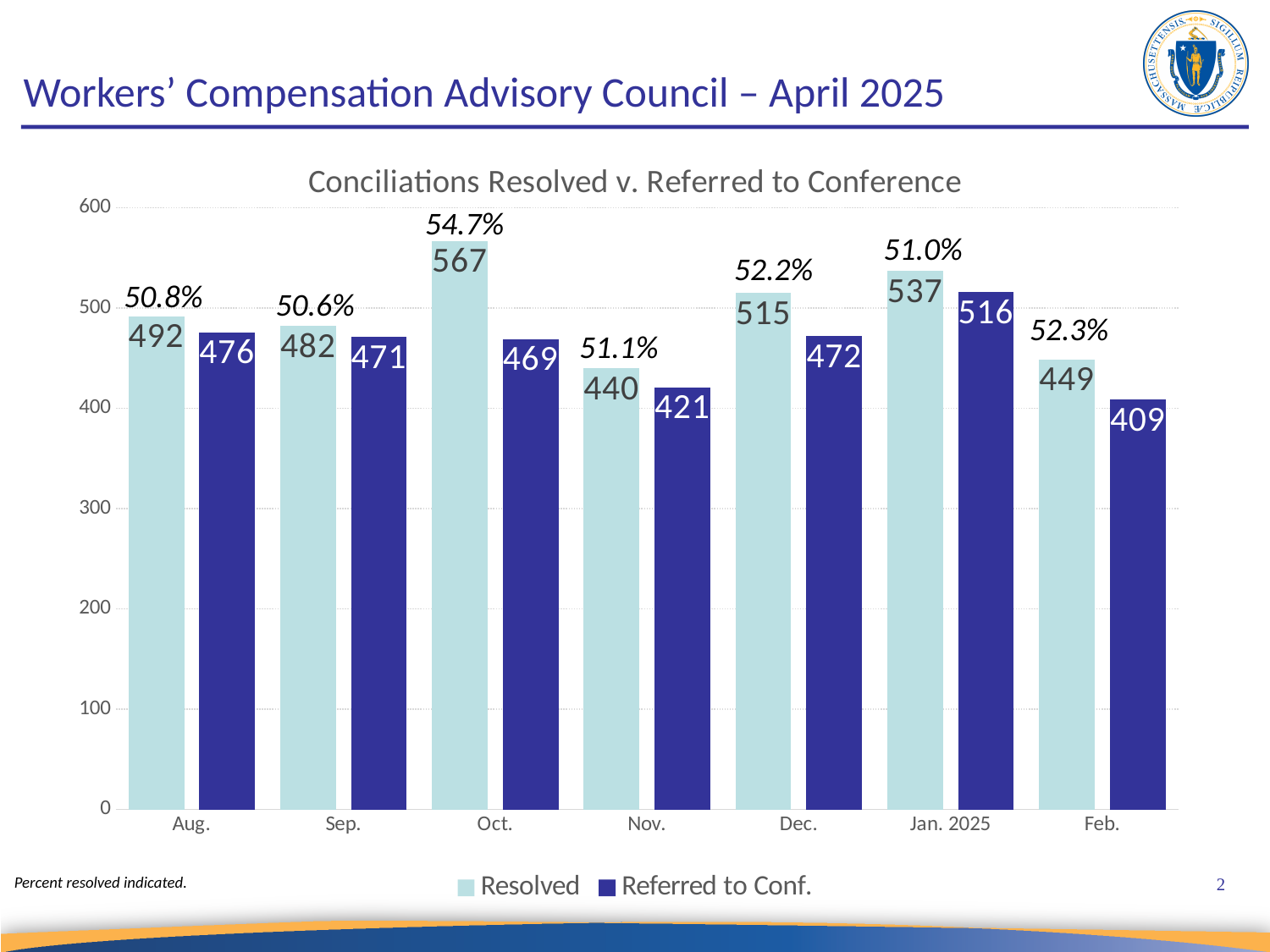
What kind of chart is shown? bar chart What is the title of the chart? Conciliations Resolved v. Referred to Conference Which month has the lowest Referred to Conf. value? Feb. How many series does the legend list? 2 Is the Referred to Conf. value for Nov. greater or less than 500? less What percent resolved is indicated for Dec.? 52.2% What is the Referred to Conf. value for Feb.? 409 How many months are shown on the x axis? 7 What is the Resolved value for Oct.? 567 Which is larger for Jan. 2025, the Resolved value or the Referred to Conf. value? Resolved What is the difference between the Resolved and Referred to Conf. values for Oct.? 98 Which month has the highest Resolved value? Oct.